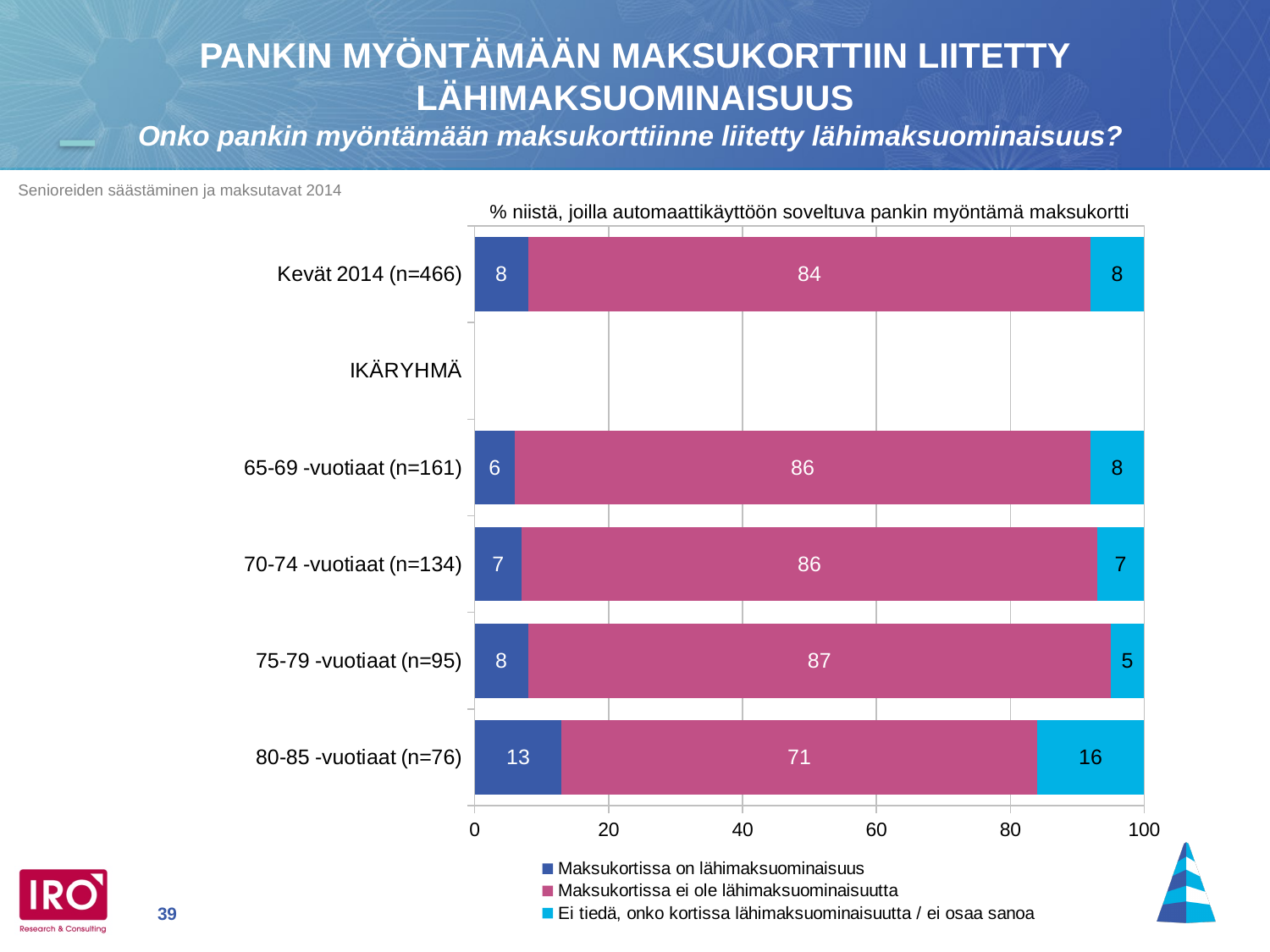
What is the value of 'Ei tiedä, onko kortissa lähimaksuominaisuutta / ei osaa sanoa' for 75-79 -vuotiaat (n=95)? 5 Which age group has the lowest value for 'Maksukortissa ei ole lähimaksuominaisuutta'? 80-85 -vuotiaat (n=76) Which age group has the highest value for 'Ei tiedä, onko kortissa lähimaksuominaisuutta / ei osaa sanoa'? 80-85 -vuotiaat (n=76) What kind of chart is shown on the slide? Stacked bar chart Which is larger: the 'Maksukortissa on lähimaksuominaisuus' value for 65-69 -vuotiaat (n=161) or for 80-85 -vuotiaat (n=76)? 80-85 -vuotiaat (n=76) What is the subtitle text shown above the chart? % niistä, joilla automaattikäyttöön soveltuva pankin myöntämä maksukortti What is the total of the stacked bar for 70-74 -vuotiaat (n=134)? 100 What is the value of 'Maksukortissa ei ole lähimaksuominaisuutta' for Kevät 2014 (n=466)? 84 How many series does the legend list? 3 What is the value of 'Maksukortissa on lähimaksuominaisuus' for 80-85 -vuotiaat (n=76)? 13 How many bars with data are plotted in the chart? 5 What is the difference between the 'Maksukortissa ei ole lähimaksuominaisuutta' values for 75-79 -vuotiaat (n=95) and 80-85 -vuotiaat (n=76)? 16